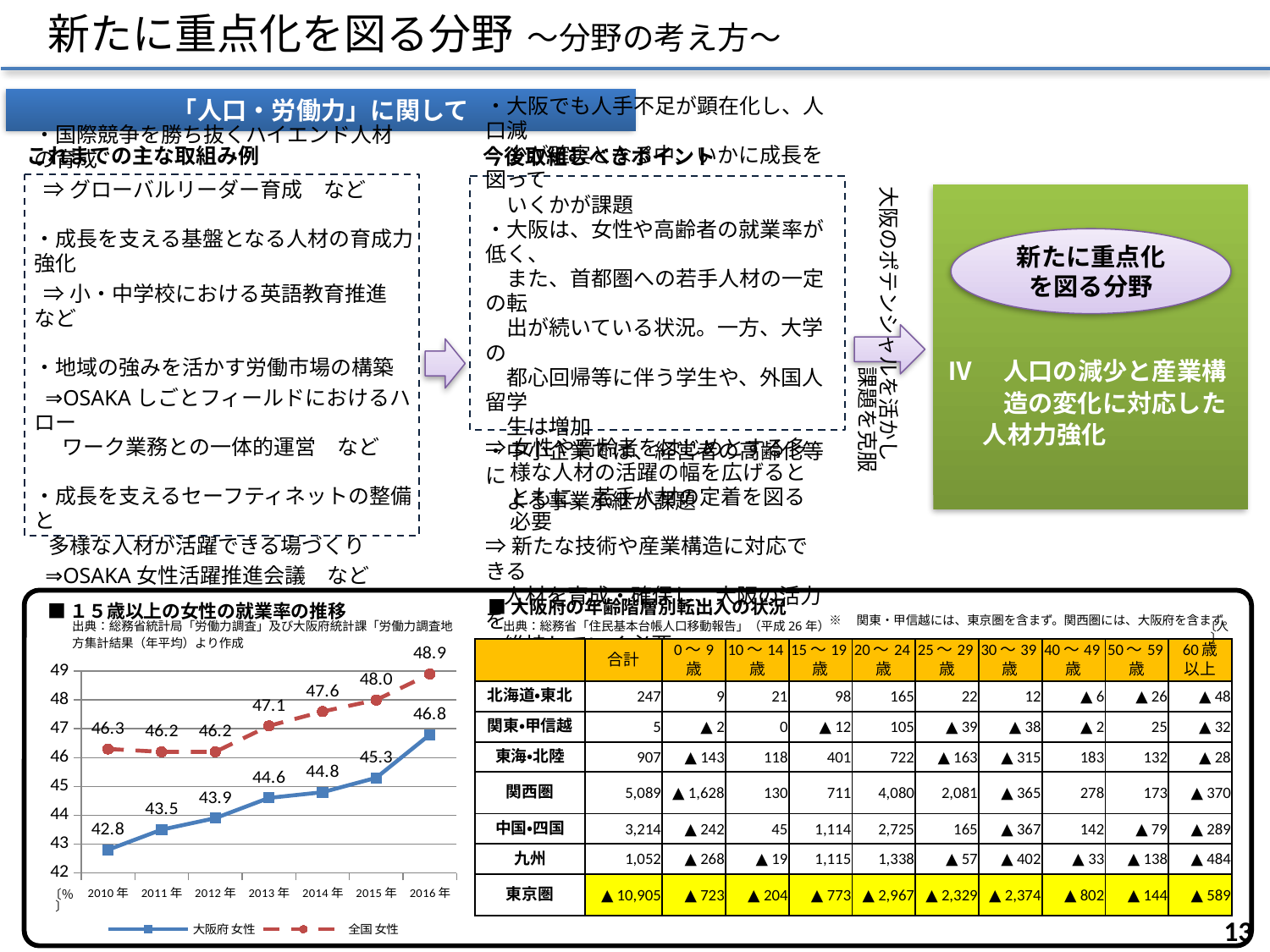
What type of chart is used for 「15歳以上の女性の就業率の推移」? line chart In the 「15歳以上の女性の就業率の推移」 chart, how many years are plotted on the x axis? 7 In the 「15歳以上の女性の就業率の推移」 chart, what is the value for 大阪府 女性 in 2014年? 44.8 In the 「15歳以上の女性の就業率の推移」 chart, which series is drawn with a dashed line? 全国 女性 In the 「15歳以上の女性の就業率の推移」 chart, what is the value for 大阪府 女性 in 2010年? 42.8 In the 「15歳以上の女性の就業率の推移」 chart, what is the value for 全国 女性 in 2016年? 48.9 In the 「15歳以上の女性の就業率の推移」 chart, does the value for 大阪府 女性 rise or fall from 2010年 to 2016年? rise In the 「15歳以上の女性の就業率の推移」 chart, what is the difference between 全国 女性 and 大阪府 女性 in 2016年? 2.1 In the 「15歳以上の女性の就業率の推移」 chart, which year has the highest value for 大阪府 女性? 2016年 In the 「15歳以上の女性の就業率の推移」 chart, which is larger in 2013年: 大阪府 女性 or 全国 女性? 全国 女性 How many series does the legend of the 「15歳以上の女性の就業率の推移」 chart list? 2 In the 「15歳以上の女性の就業率の推移」 chart, which year has the lowest value for 全国 女性? 2011年 and 2012年 (both 46.2)